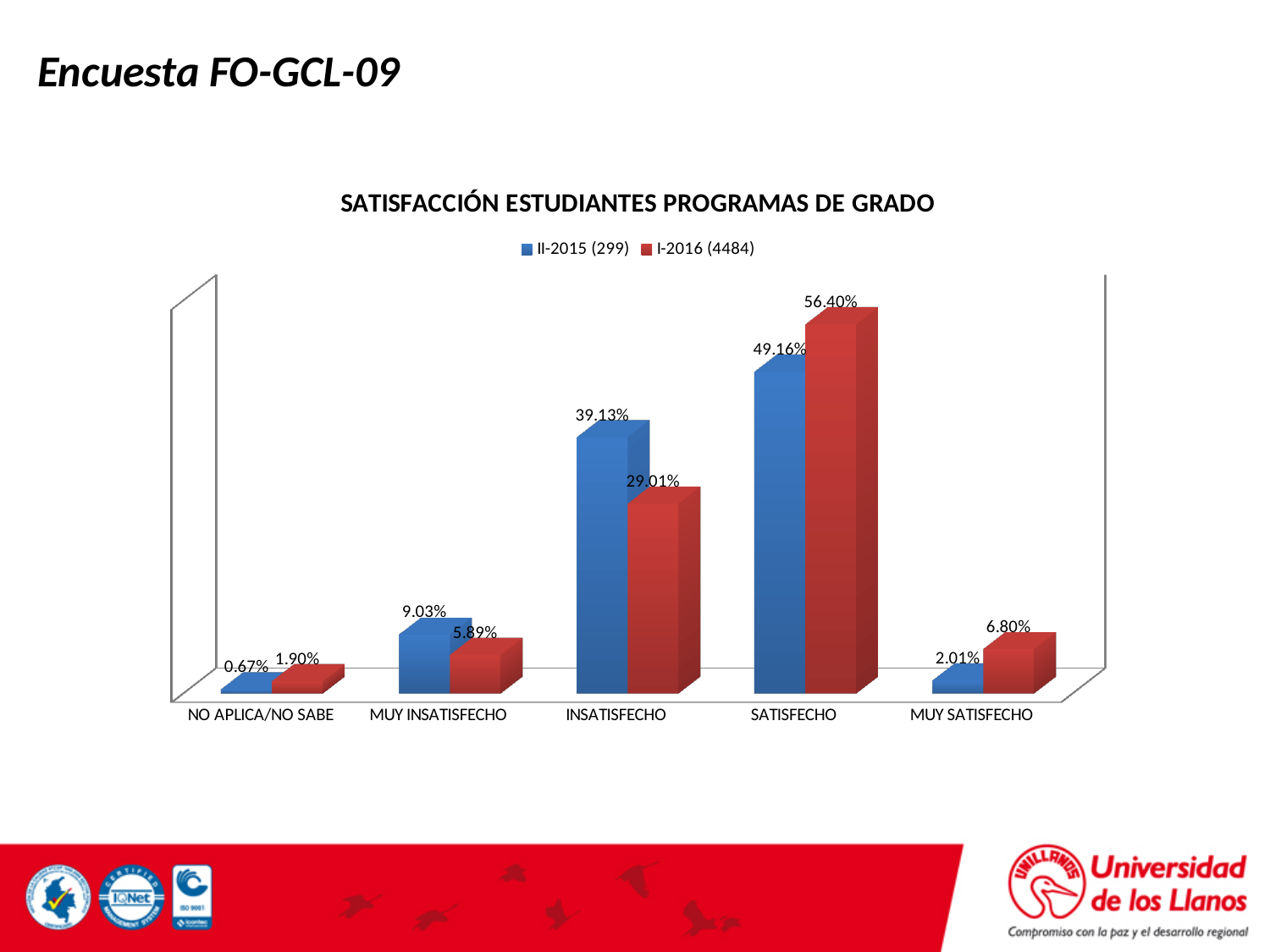
What kind of chart is shown on the slide? Bar chart Which category has the lowest value in the II-2015 (299) series? NO APLICA/NO SABE What is the value for INSATISFECHO in the I-2016 (4484) series? 29.01% What colour represents the I-2016 (4484) series? Red How many series does the legend list? 2 Which category has the highest value in the I-2016 (4484) series? SATISFECHO Which series has the larger value for INSATISFECHO, II-2015 (299) or I-2016 (4484)? II-2015 (299) What is the title of the chart? SATISFACCIÓN ESTUDIANTES PROGRAMAS DE GRADO What is the value for SATISFECHO in the II-2015 (299) series? 49.16% What is the difference between the I-2016 (4484) and II-2015 (299) values for SATISFECHO? 7.24% What is the value for MUY SATISFECHO in the I-2016 (4484) series? 6.80% How many categories are shown on the x axis? 5